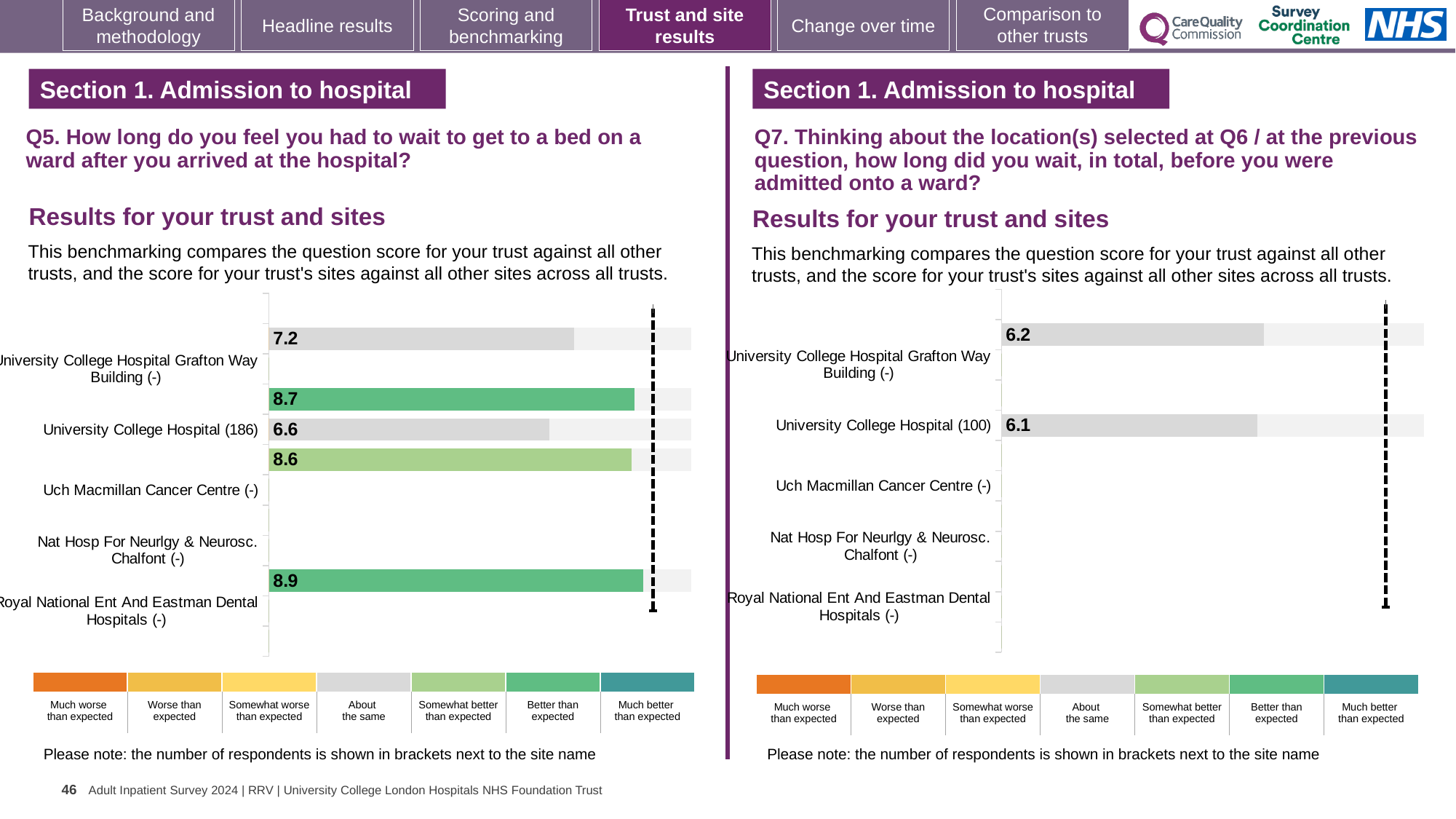
What type of chart is used on the Q5 chart on the left? Bar chart On the Q5 chart on the left, what is the lowest value printed on any bar? 6.6 How many bars with data labels are shown on the Q7 chart on the right? 2 On the Q7 chart on the right, what is the value shown for University College Hospital (100)? 6.1 On the Q5 chart on the left, what is the difference between the highest bar value (8.9) and the lowest bar value (6.6)? 2.3 How many categories does the colour key below the Q5 chart on the left list? 7 On the Q5 chart on the left, how many respondents are shown in brackets for University College Hospital? 186 How many bars with data labels are shown on the Q5 chart on the left? 5 On the Q7 chart on the right, which is larger: the bar labelled 6.2 or the bar labelled 6.1? 6.2 On the Q7 chart on the right, what is the difference between the two bar values 6.2 and 6.1? 0.1 On the Q5 chart on the left, what is the highest value printed on any bar? 8.9 On the Q5 chart on the left, what is the value shown for University College Hospital (186)? 6.6